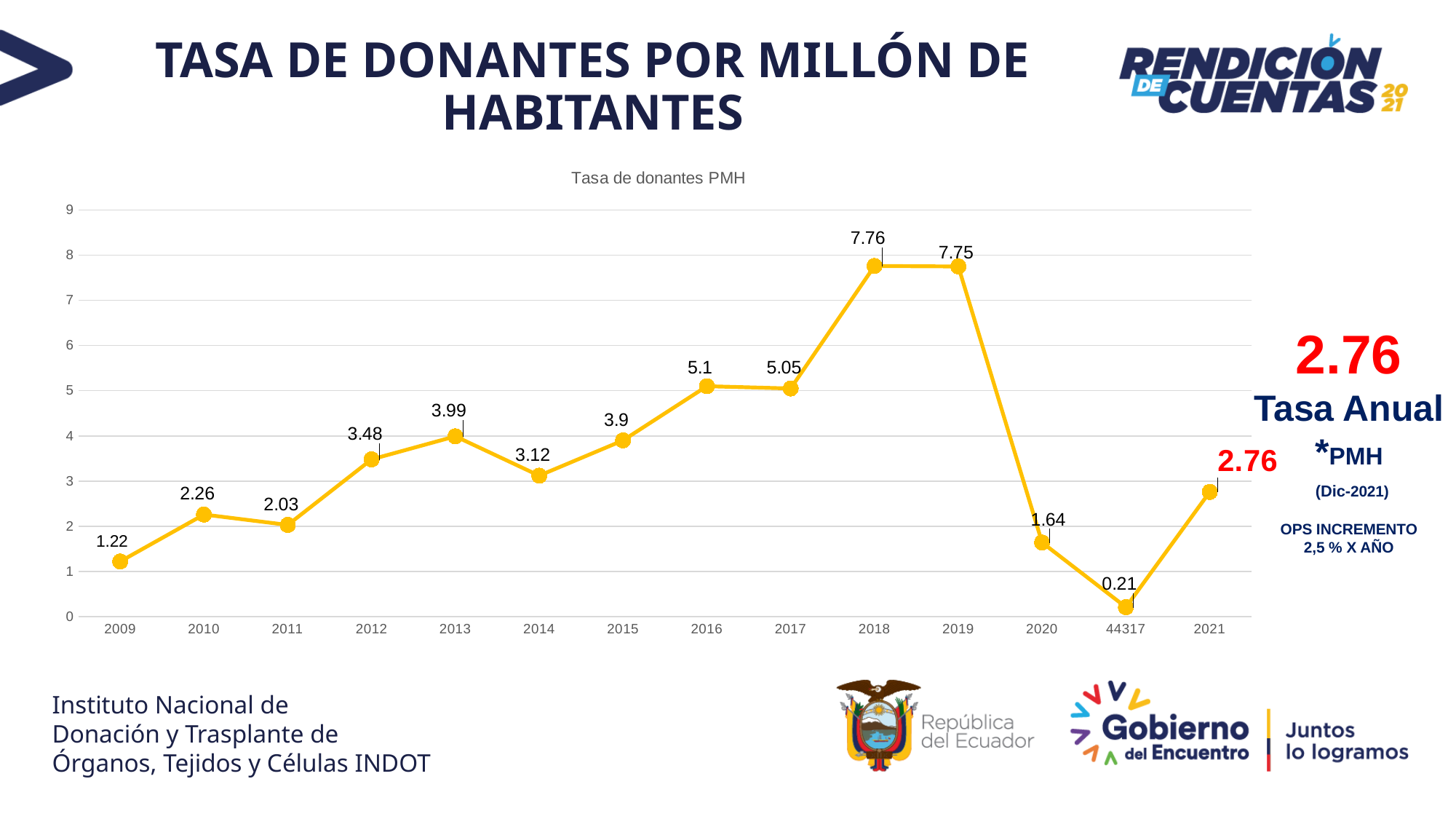
What is the title shown above the chart? Tasa de donantes PMH Is the value for 2013 greater or less than 3? greater What is the lowest value plotted on the chart? 0.21 Do the values rise or fall from 2009 to 2013? rise What is the value for 2021? 2.76 What is the value for 2014? 3.12 What is the value for 2009? 1.22 What is the difference between the values for 2019 and 2020? 6.11 What type of chart is shown on the slide? line chart What is the value for 2018? 7.76 Which is larger, the value for 2016 or the value for 2017? 2016 How many data points are plotted on the chart? 14